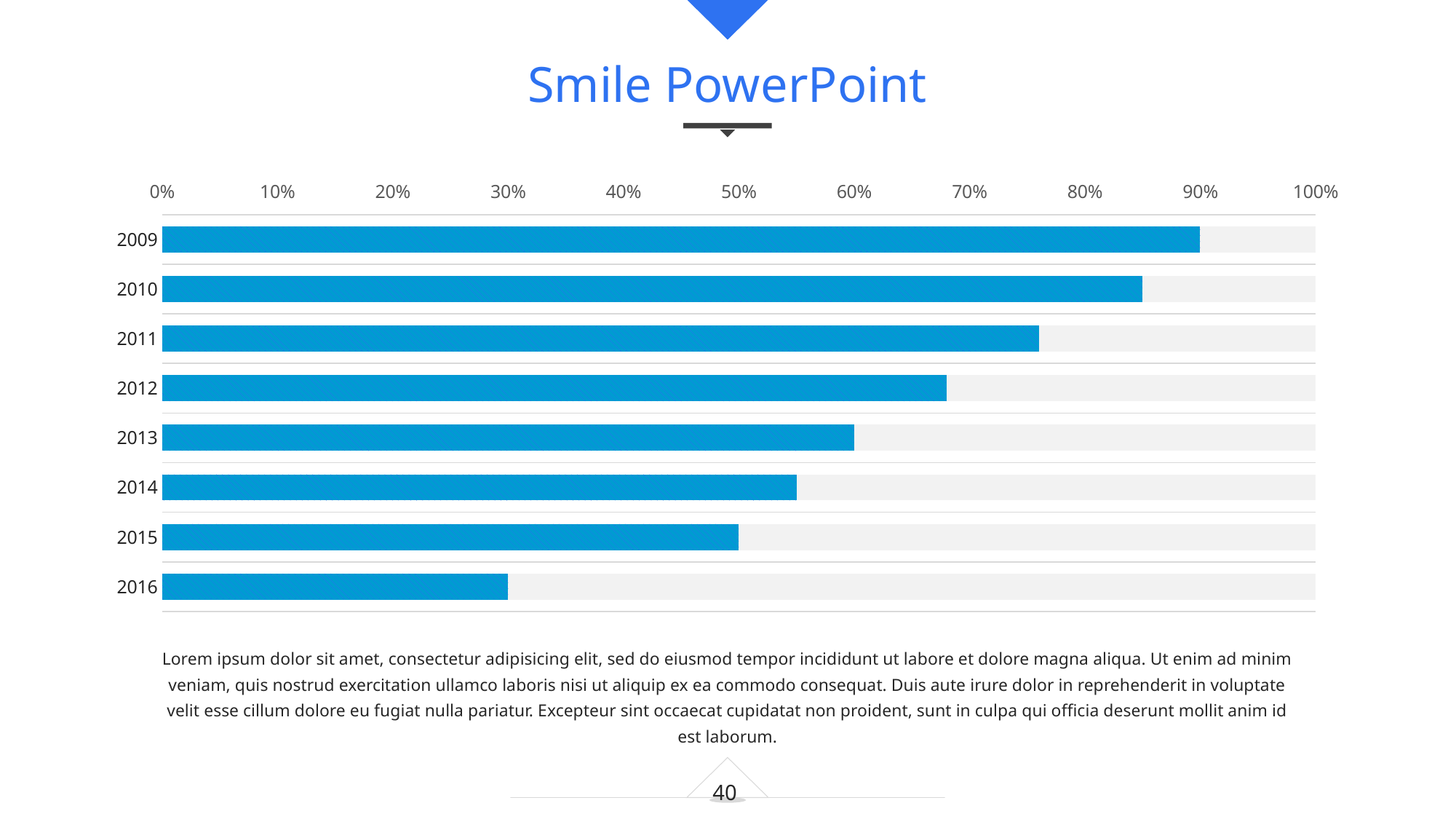
Which has the larger value, 2011 or 2013? 2011 What kind of chart is shown on the slide? bar chart Do the values rise or fall from 2009 to 2016? fall Is the value for 2014 greater or less than 50%? greater How many years are plotted in the chart? 8 Is the value for 2011 greater or less than 80%? less What value does the bar for 2009 reach on the axis? 90% Which year has the highest value in the chart? 2009 What is the highest value shown on the horizontal axis? 100% Is the value for 2010 greater or less than 80%? greater Which year has the lowest value in the chart? 2016